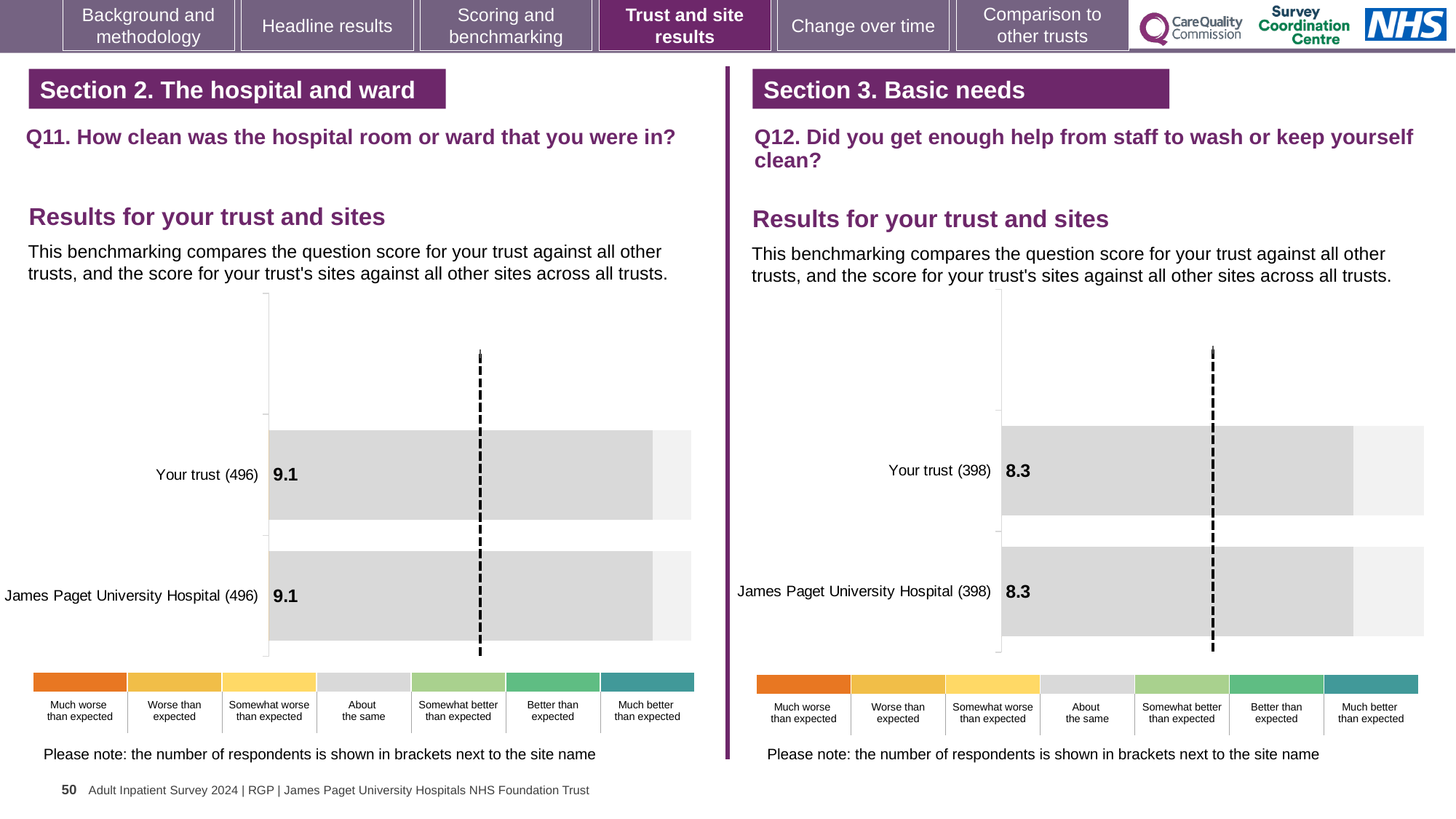
How many bars are plotted on the Q11 chart (left)? 2 On the Q11 chart (left), what is the difference between the score for Your trust and the score for James Paget University Hospital? 0 How many bars are plotted on the Q12 chart (right)? 2 On the Q12 chart (right), what is the difference between the score for Your trust and the score for James Paget University Hospital? 0 On the Q11 chart (left), what is the score for James Paget University Hospital (496)? 9.1 Is the Your trust score on the Q11 chart (left) larger or smaller than the Your trust score on the Q12 chart (right)? Larger How many respondents are shown in brackets for Your trust on the Q12 chart (right)? 398 On the Q11 chart (left), what is the score for Your trust (496)? 9.1 On the Q12 chart (right), what is the score for James Paget University Hospital (398)? 8.3 On the Q12 chart (right), what is the score for Your trust (398)? 8.3 What kind of chart is used for the Q11 results on the left? Bar chart According to the colour key, which category does the grey bar colour on the Q11 chart (left) represent? About the same